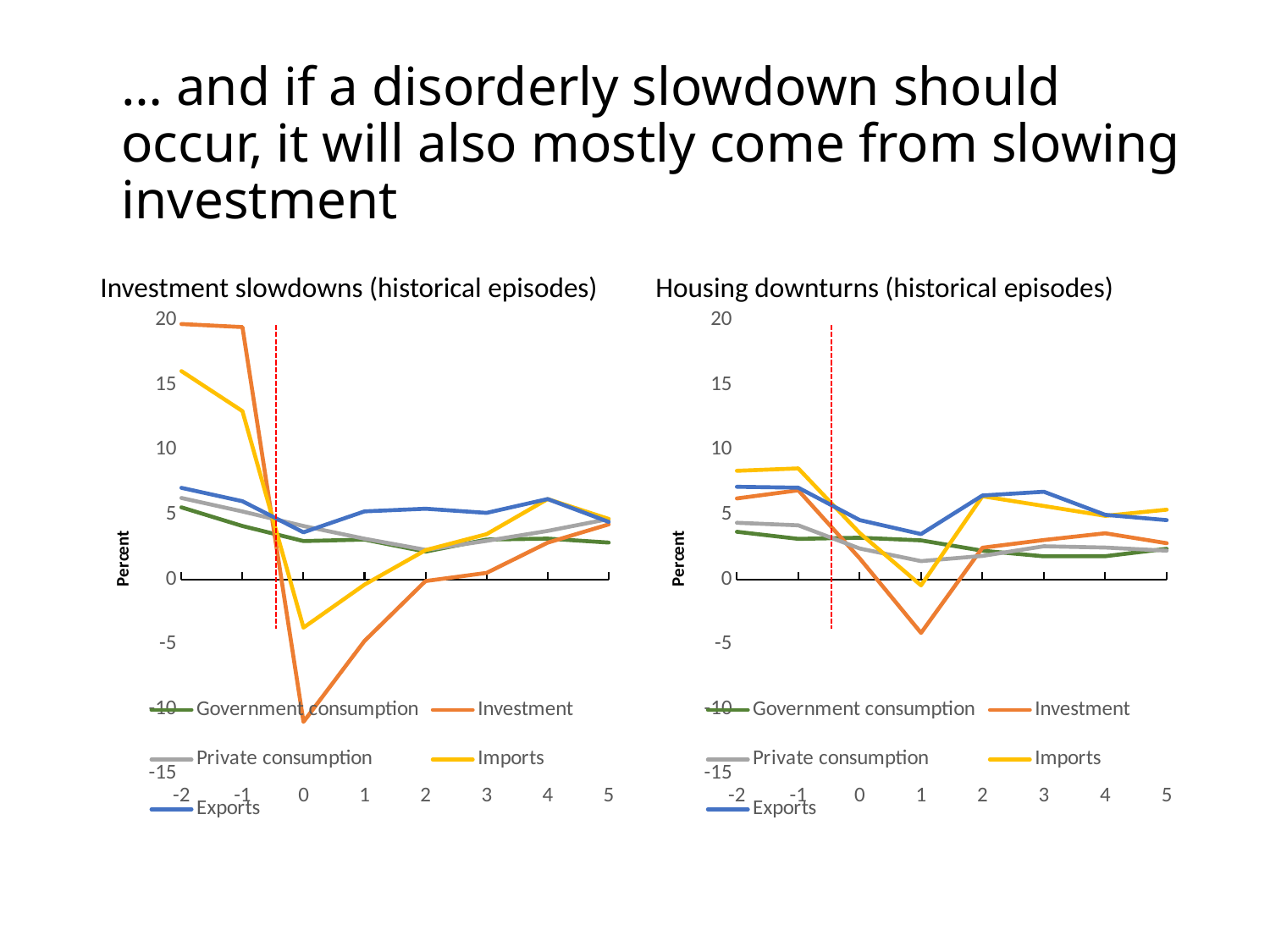
In the 'Investment slowdowns (historical episodes)' chart, is the value for Imports at x = -2 greater or less than 15? greater How many x-axis points are plotted in the 'Investment slowdowns (historical episodes)' chart? 8 In the 'Housing downturns (historical episodes)' chart, does the Exports line rise or fall from x = -2 to x = 1? fall What kind of chart is the 'Investment slowdowns (historical episodes)' chart? line chart In the 'Investment slowdowns (historical episodes)' chart, is the value for Investment at x = 0 greater or less than -10? less How many series does the legend of the 'Housing downturns (historical episodes)' chart list? 5 What is the y-axis label of the 'Investment slowdowns (historical episodes)' chart? Percent In the 'Investment slowdowns (historical episodes)' chart, which series has the highest value at x = -2? Investment In the 'Investment slowdowns (historical episodes)' chart, which series has the lowest value at x = 0? Investment In the 'Housing downturns (historical episodes)' chart, which series has the lowest value at x = 1? Investment In the 'Housing downturns (historical episodes)' chart, is the value for Investment at x = 1 greater or less than 0? less